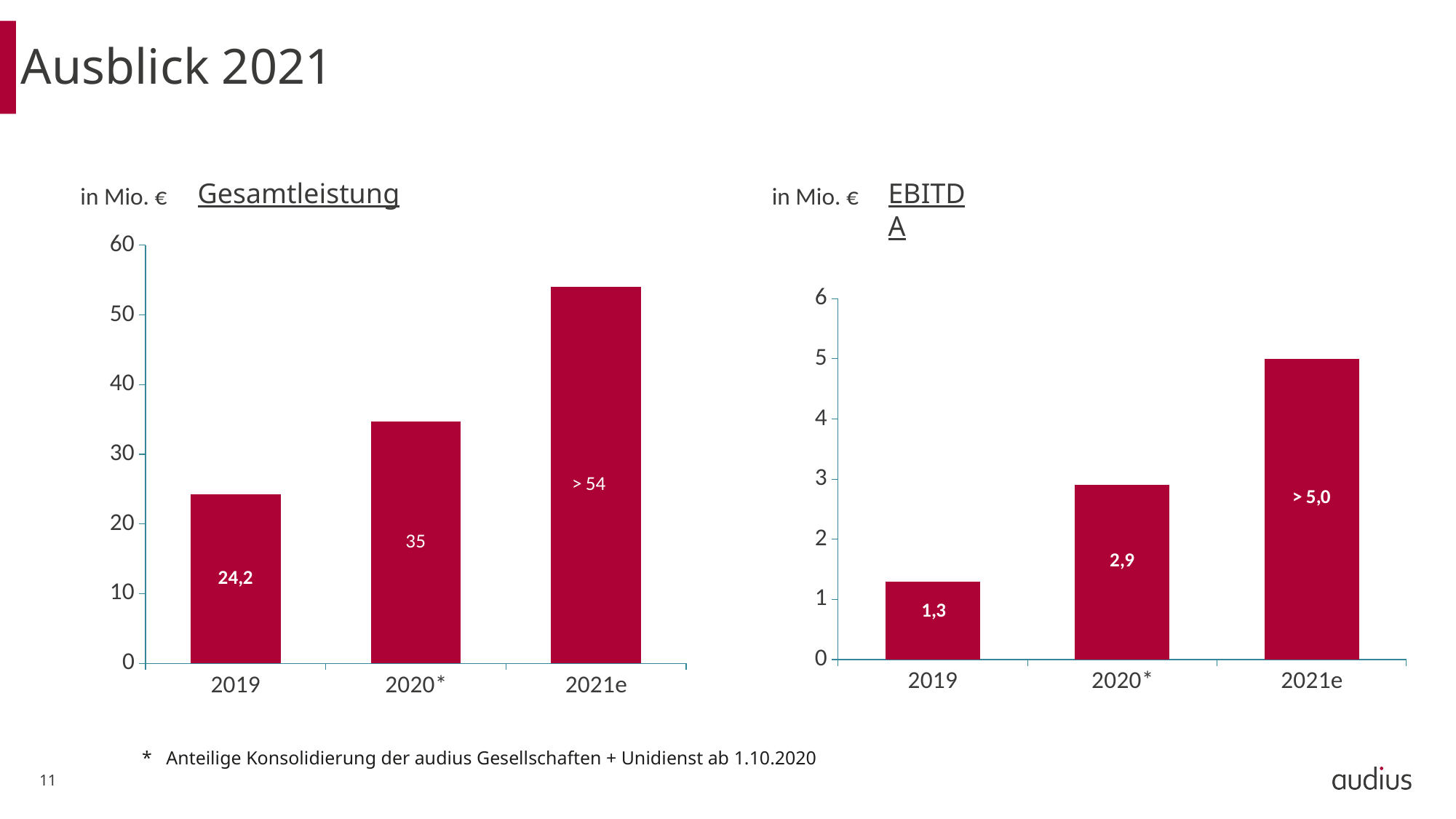
In the Gesamtleistung chart, which year has the highest value? 2021e In the EBITDA chart, which year has the lowest value? 2019 In the EBITDA chart, what is the difference between the 2020* and 2019 values? 1,6 In the Gesamtleistung chart, what is the value for 2019? 24,2 What kind of chart is the Gesamtleistung chart? Bar chart In the EBITDA chart, what is the value for 2020*? 2,9 In the Gesamtleistung chart, what is the difference between the 2020* and 2019 values? 10,8 In the EBITDA chart, what is the value for 2019? 1,3 In the Gesamtleistung chart, what is the value for 2020*? 35 How many bars are shown in the EBITDA chart? 3 In the EBITDA chart, what label is shown on the 2021e bar? > 5,0 In the Gesamtleistung chart, what label is shown on the 2021e bar? > 54